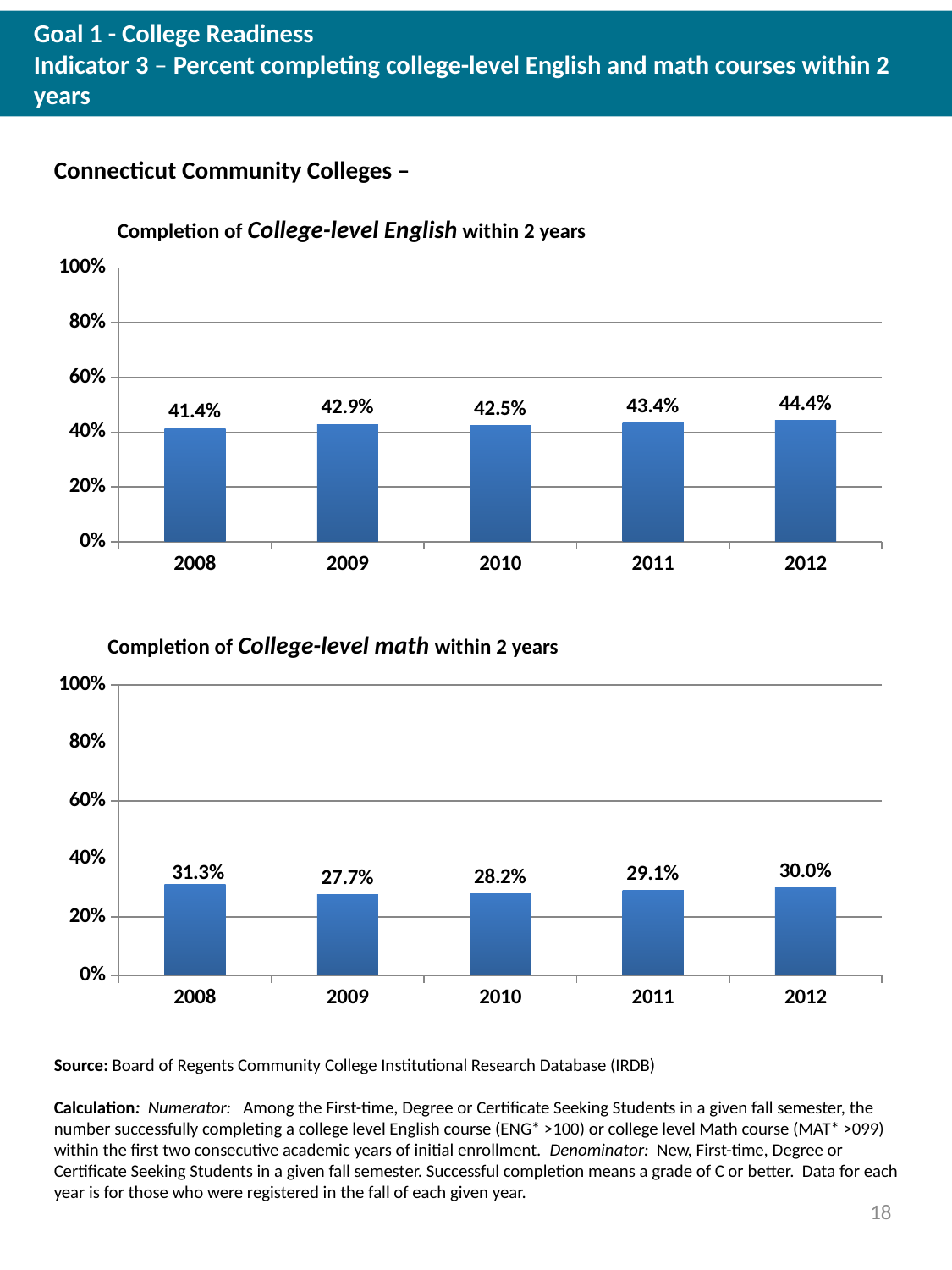
In the 'Completion of College-level English within 2 years' chart, is the value for 2011 greater or less than 40%? greater In the 'Completion of College-level math within 2 years' chart, what is the difference between the 2008 and 2009 values? 3.6% In the 'Completion of College-level English within 2 years' chart, what is the difference between the 2012 and 2008 values? 3.0% In the 'Completion of College-level math within 2 years' chart, what is the value for 2009? 27.7% In the 'Completion of College-level math within 2 years' chart, which year has the highest value? 2008 In the 'Completion of College-level English within 2 years' chart, is the 2009 value larger or smaller than the 2008 value? larger In the 'Completion of College-level math within 2 years' chart, is the value for 2012 greater or less than 40%? less In the 'Completion of College-level English within 2 years' chart, which year has the highest value? 2012 In the 'Completion of College-level English within 2 years' chart, what is the value for 2010? 42.5% How many years are shown in the 'Completion of College-level English within 2 years' chart? 5 In the 'Completion of College-level math within 2 years' chart, which year has the lowest value? 2009 What kind of chart is the 'Completion of College-level math within 2 years' chart? Bar chart